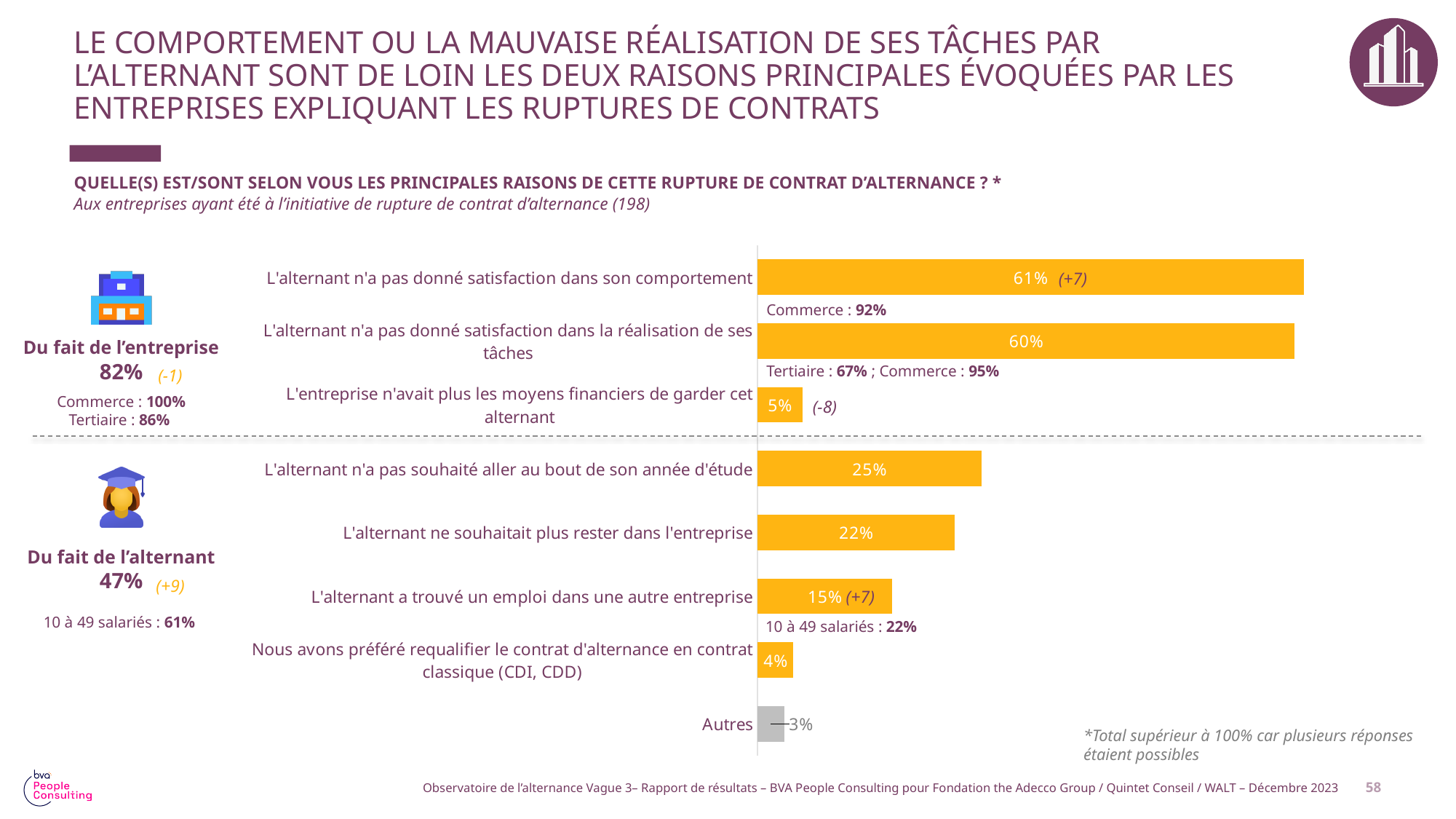
What is the difference between the percentages for "L'alternant n'a pas souhaité aller au bout de son année d'étude" and "L'alternant ne souhaitait plus rester dans l'entreprise"? 3 points What value is shown for "L'alternant n'a pas souhaité aller au bout de son année d'étude"? 25% What is the value shown for "L'alternant n'a pas donné satisfaction dans la réalisation de ses tâches"? 60% What is the overall percentage shown for "Du fait de l'entreprise"? 82% Which reason has the lowest percentage in the chart? Autres What percentage of companies cited "L'alternant n'a pas donné satisfaction dans son comportement" as a reason for the contract termination? 61% What percentage is shown for "L'entreprise n'avait plus les moyens financiers de garder cet alternant"? 5% How many reasons (bars) are shown in the chart? 8 Which reason has the highest percentage in the chart? L'alternant n'a pas donné satisfaction dans son comportement What percentage is shown for "Autres"? 3% Which is larger: the value for "L'alternant a trouvé un emploi dans une autre entreprise" or the value for "Nous avons préféré requalifier le contrat d'alternance en contrat classique (CDI, CDD)"? L'alternant a trouvé un emploi dans une autre entreprise What type of chart is used on this slide? Bar chart